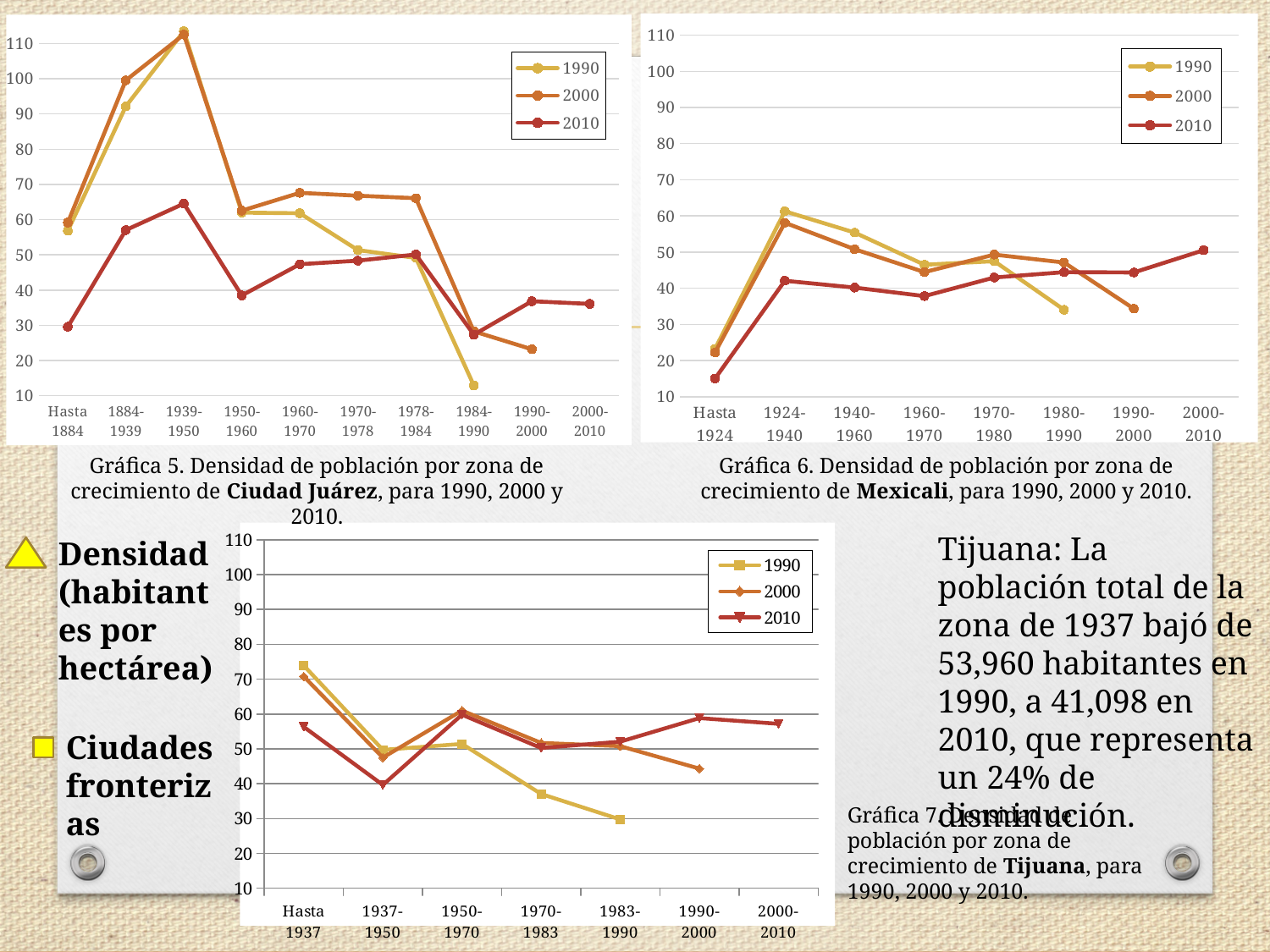
What kind of chart is Gráfica 5 (Ciudad Juárez)? line chart In Gráfica 5 (Ciudad Juárez), which growth zone has the lowest value for the 1990 series? 1984-1990 How many growth-zone categories are shown on the x axis of Gráfica 7 (Tijuana)? 7 In Gráfica 5 (Ciudad Juárez), is the 1990 value for 1984-1990 greater or less than 20? less In Gráfica 6 (Mexicali), which growth zone has the highest value for the 1990 series? 1924-1940 In Gráfica 6 (Mexicali), for the 1924-1940 zone, which series is larger: 1990 or 2010? 1990 How many growth-zone categories are shown on the x axis of Gráfica 5 (Ciudad Juárez)? 10 In Gráfica 7 (Tijuana), is the 1990 value for Hasta 1937 greater or less than 70? greater How many growth-zone categories are shown on the x axis of Gráfica 6 (Mexicali)? 8 How many series does the legend of Gráfica 5 (Ciudad Juárez) list? 3 In Gráfica 6 (Mexicali), is the 2010 value for Hasta 1924 greater or less than 20? less In Gráfica 5 (Ciudad Juárez), which growth zone has the highest value for the 2000 series? 1939-1950